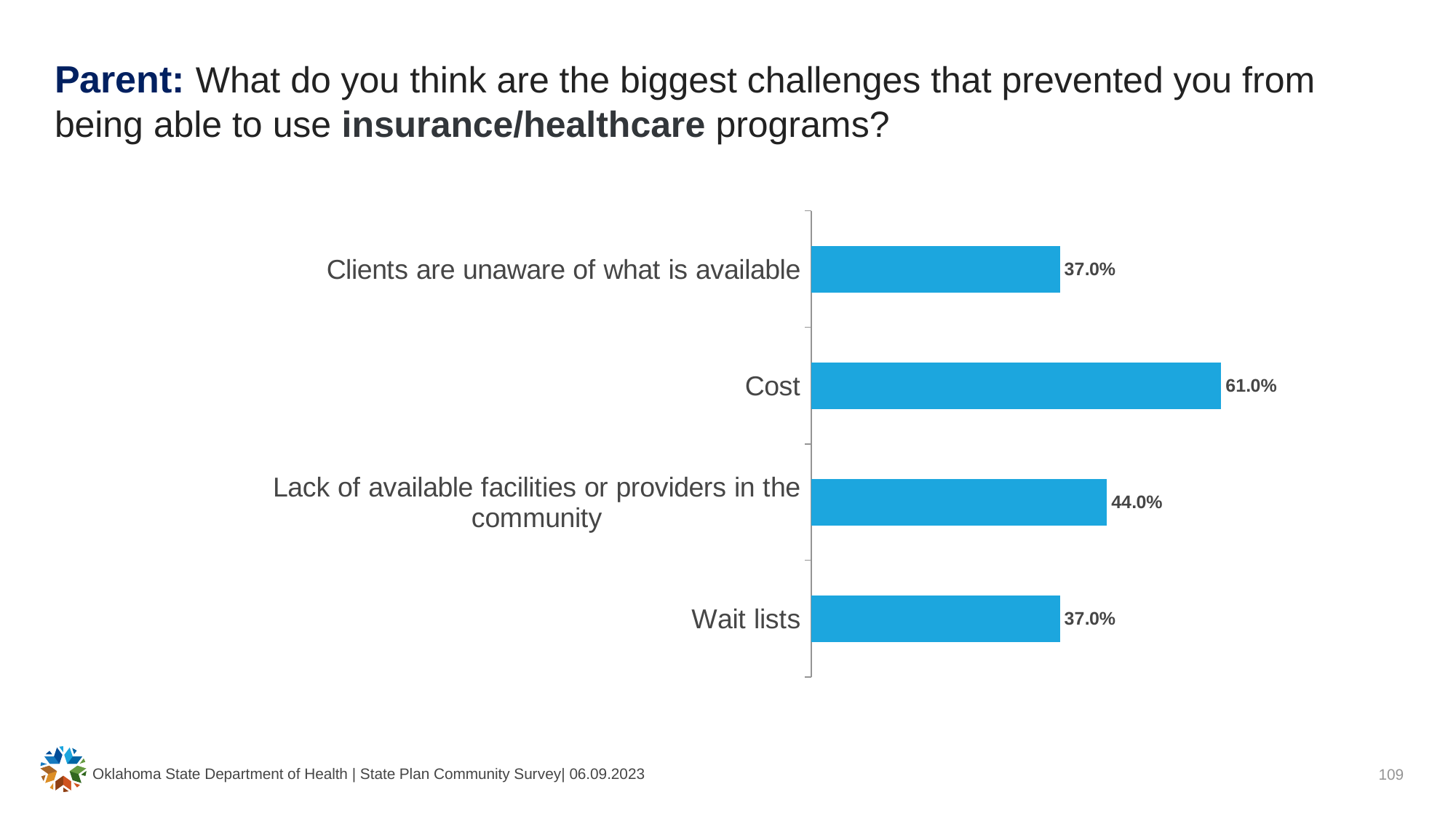
Which is larger: the value for Cost or the value for 'Lack of available facilities or providers in the community'? Cost How many challenge categories are shown in the chart? 4 What is the value shown for 'Lack of available facilities or providers in the community'? 44.0% What is the value shown for 'Wait lists'? 37.0% Which two categories share the same value of 37.0%? Clients are unaware of what is available; Wait lists What is the difference in percentage points between Cost and 'Lack of available facilities or providers in the community'? 17.0 What percentage of parents cited Cost as a challenge to using insurance/healthcare programs? 61.0% What is the value shown for 'Clients are unaware of what is available'? 37.0% What type of chart is shown on the slide? Bar chart Which challenge has the highest percentage? Cost What is the difference in percentage points between Cost and Wait lists? 24.0 What colour are the bars in the chart? Blue